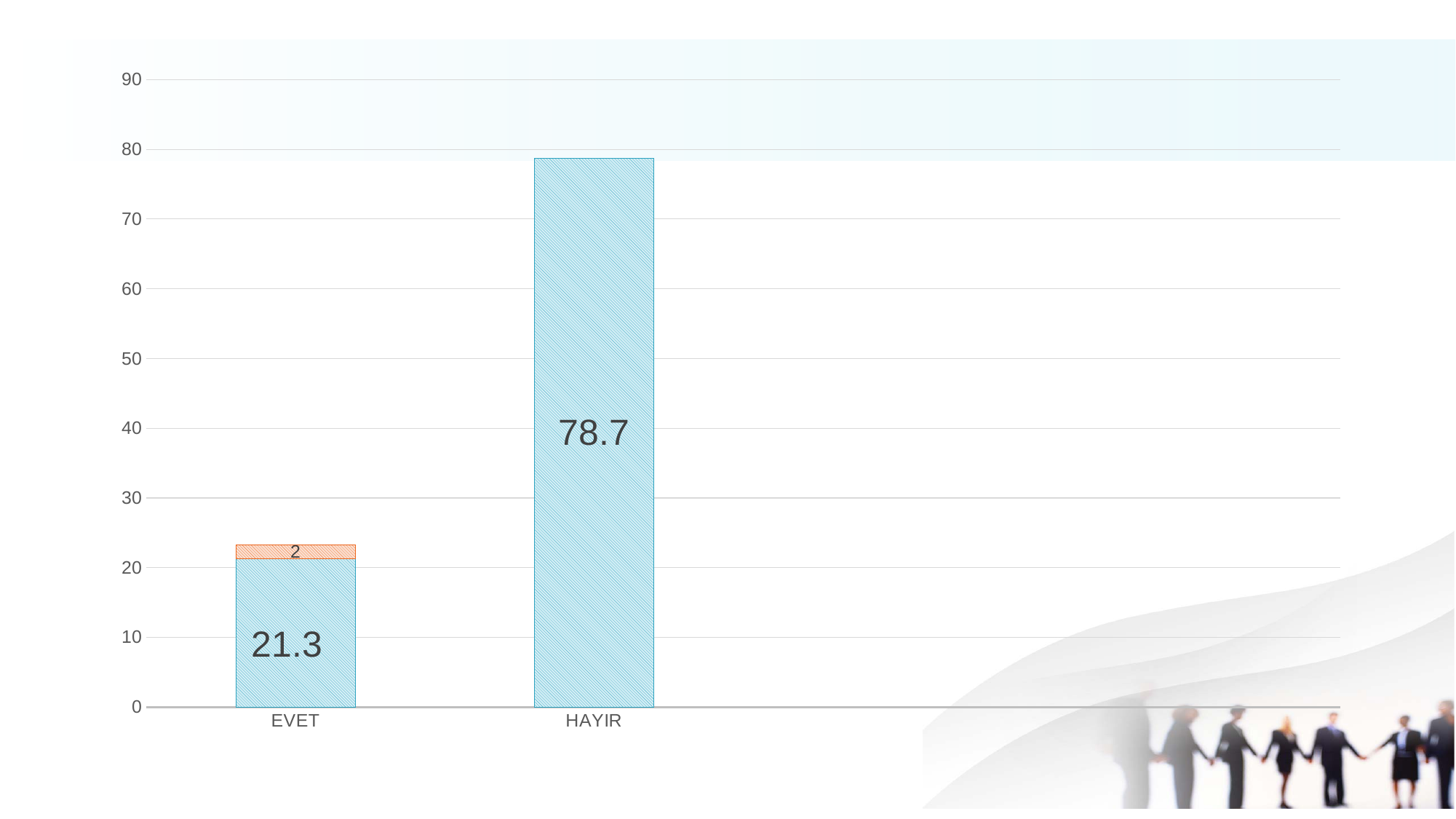
Which is larger, the value for HAYIR or the blue value for EVET? HAYIR Which category has the shortest bar? EVET What is the value of the orange segment on the EVET bar? 2 Is the value for HAYIR greater or less than 70? greater What is the value for HAYIR? 78.7 What is the difference between the HAYIR value and the blue EVET value? 57.4 What colour is the small top segment of the EVET bar? orange What is the value of the blue segment for EVET? 21.3 What kind of chart is shown on the slide? bar chart What is the total of the stacked EVET bar? 23.3 Which category has the tallest bar? HAYIR How many categories are shown on the x axis? 2